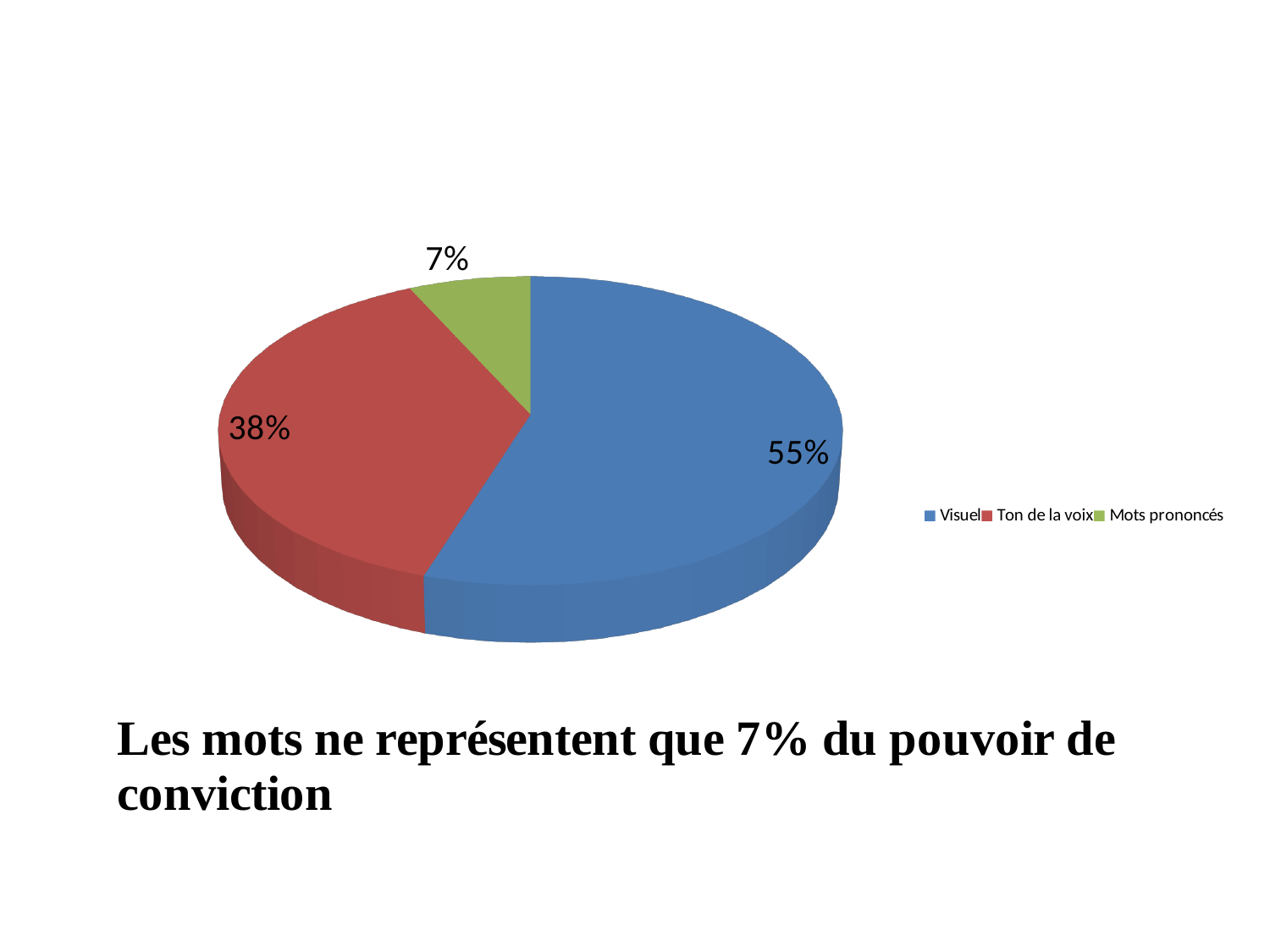
What kind of chart is shown on the slide? pie chart What share of the pie does Mots prononcés represent? 7% What is the difference in percentage points between Visuel and Ton de la voix? 17 What colour is the slice for Ton de la voix? red What is the difference in percentage points between Ton de la voix and Mots prononcés? 31 How many entries does the legend list? 3 Which category has the smallest slice of the pie? Mots prononcés Which category has the largest slice of the pie? Visuel How many slices does the pie chart have? 3 What share of the pie does Visuel represent? 55% Which is larger, the slice for Ton de la voix or the slice for Mots prononcés? Ton de la voix What share of the pie does Ton de la voix represent? 38%